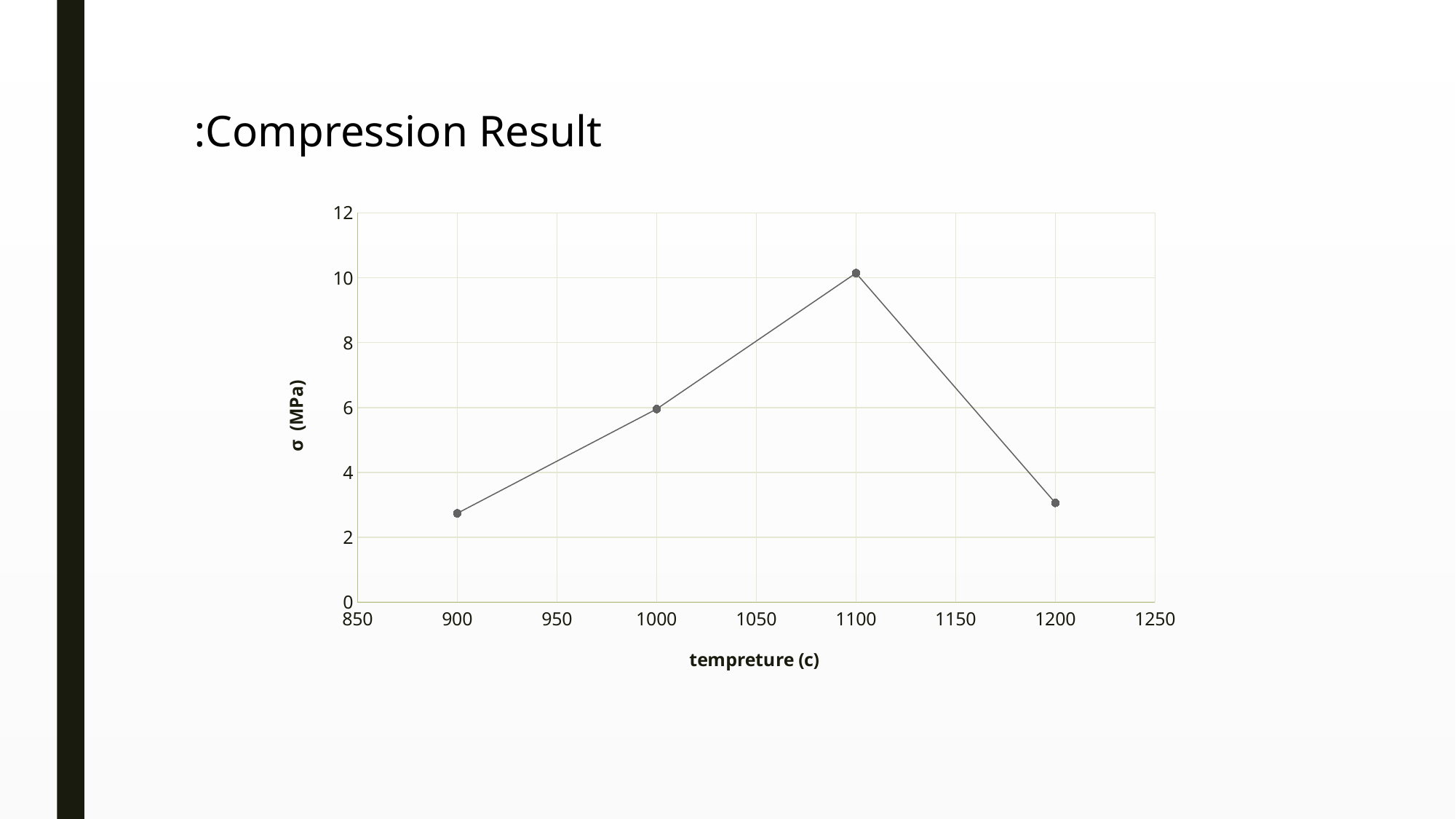
What is the label of the y axis? σ (MPa) At which temperature is the compressive stress σ highest? 1100 What is the label of the x axis? tempreture (c) How many data points are plotted on the chart? 4 What kind of chart is shown on the slide? line chart Is the value of σ at 1200 greater or less than 4? less Is the value of σ at 1100 greater or less than 8? greater Is the value of σ at 900 greater or less than 4? less How does σ change as temperature increases from 900 to 1100? it rises Which has the larger σ value, the point at 1000 or the point at 1100? 1100 Which has the larger σ value, the point at 900 or the point at 1100? 1100